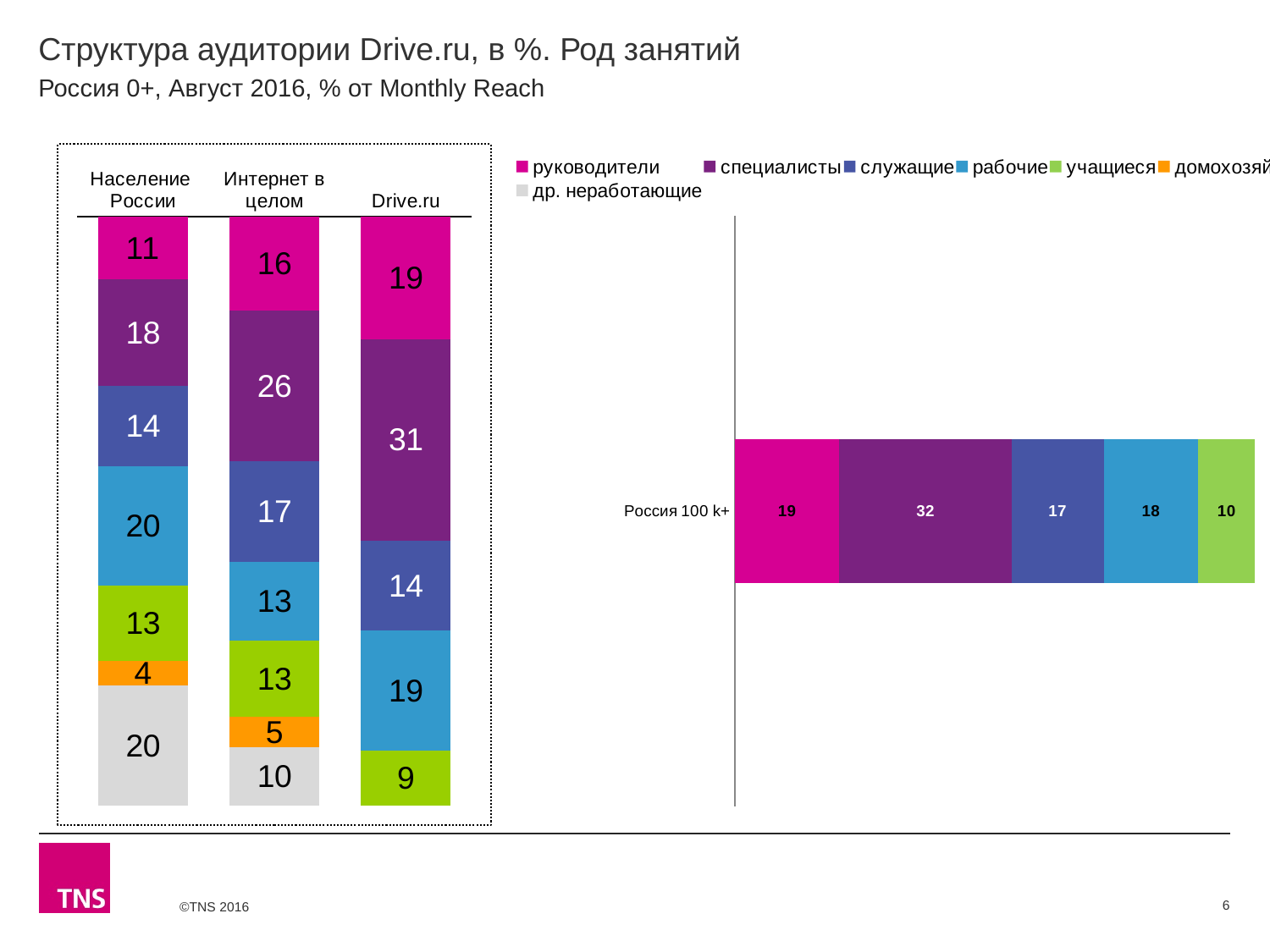
In the right chart, which series has the lowest value for Россия 100 k+? учащиеся In the left chart, what is the difference between the специалисты values for Drive.ru and Интернет в целом? 5 In the left chart, which category has the highest value for специалисты? Drive.ru In the right chart, what is the value for специалисты for Россия 100 k+? 32 In the left chart, what is the value for рабочие in the Население России bar? 20 In the left chart, what is the value for учащиеся in the Интернет в целом bar? 13 What kind of chart is the left chart? Stacked bar chart How many series does the legend list? 7 How many categories (bars) are shown in the left chart? 3 In the left chart, what is the value for специалисты in the Drive.ru bar? 31 In the left chart, which has the larger руководители value: Drive.ru or Население России? Drive.ru In the left chart, what is the total of the Drive.ru bar? 92